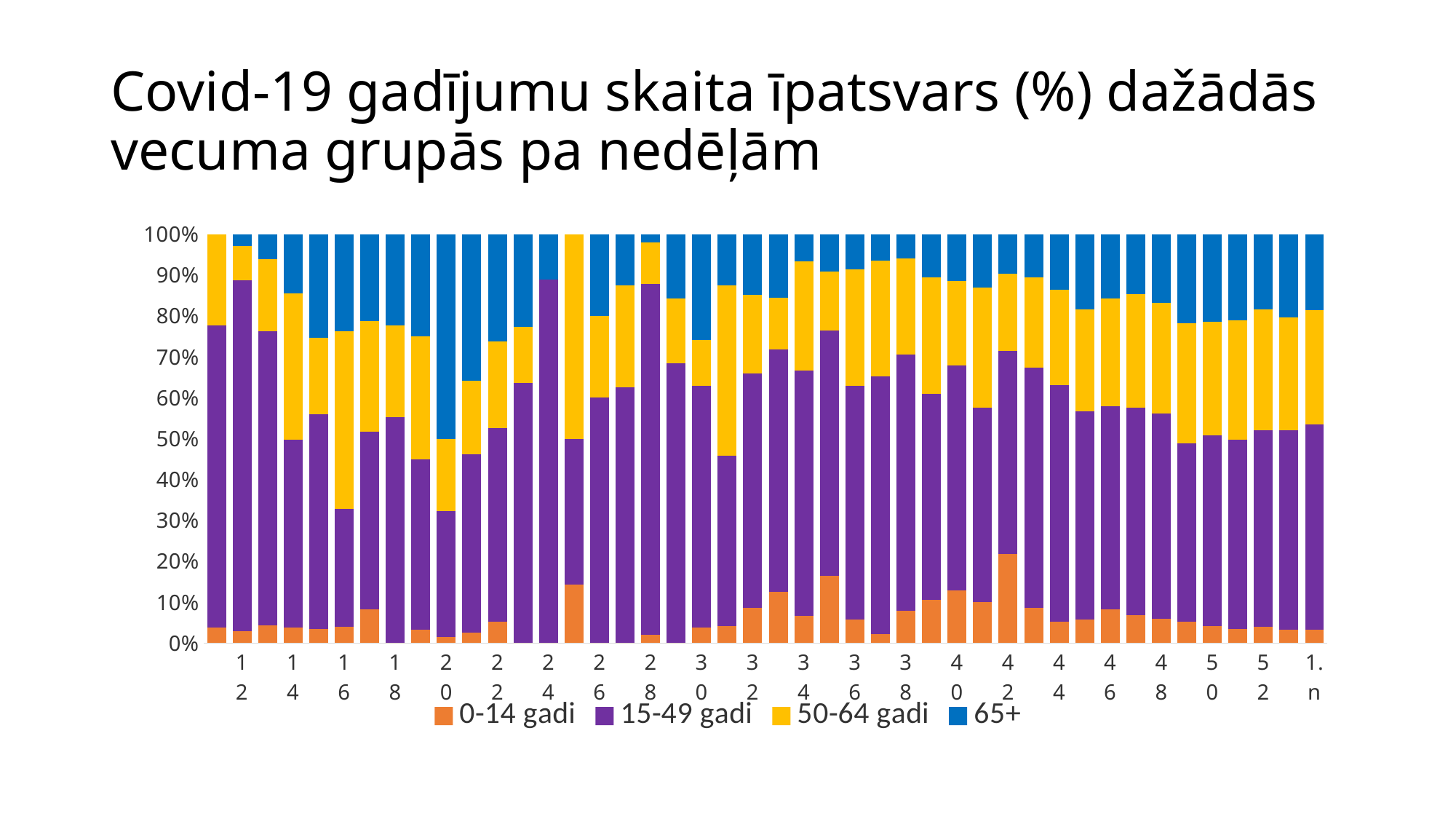
Is the 0-14 gadi share for week 42 greater or less than 10%? greater Which week has the larger 65+ share, week 20 or week 24? 20 Which age group is shown in orange in the legend? 0-14 gadi Is the 15-49 gadi share for week 20 greater or less than 40%? less Is the 15-49 gadi share for week 24 greater or less than 80%? greater Which week has the largest share for the 0-14 gadi group? 42 What kind of chart is shown on the slide? Stacked bar chart Which week has the larger 15-49 gadi share, week 20 or week 24? 24 How many series does the legend list? 4 What is the total height of the stacked bar for week 30? 100% What is the title of the chart on the slide? Covid-19 gadījumu skaita īpatsvars (%) dažādās vecuma grupās pa nedēļām